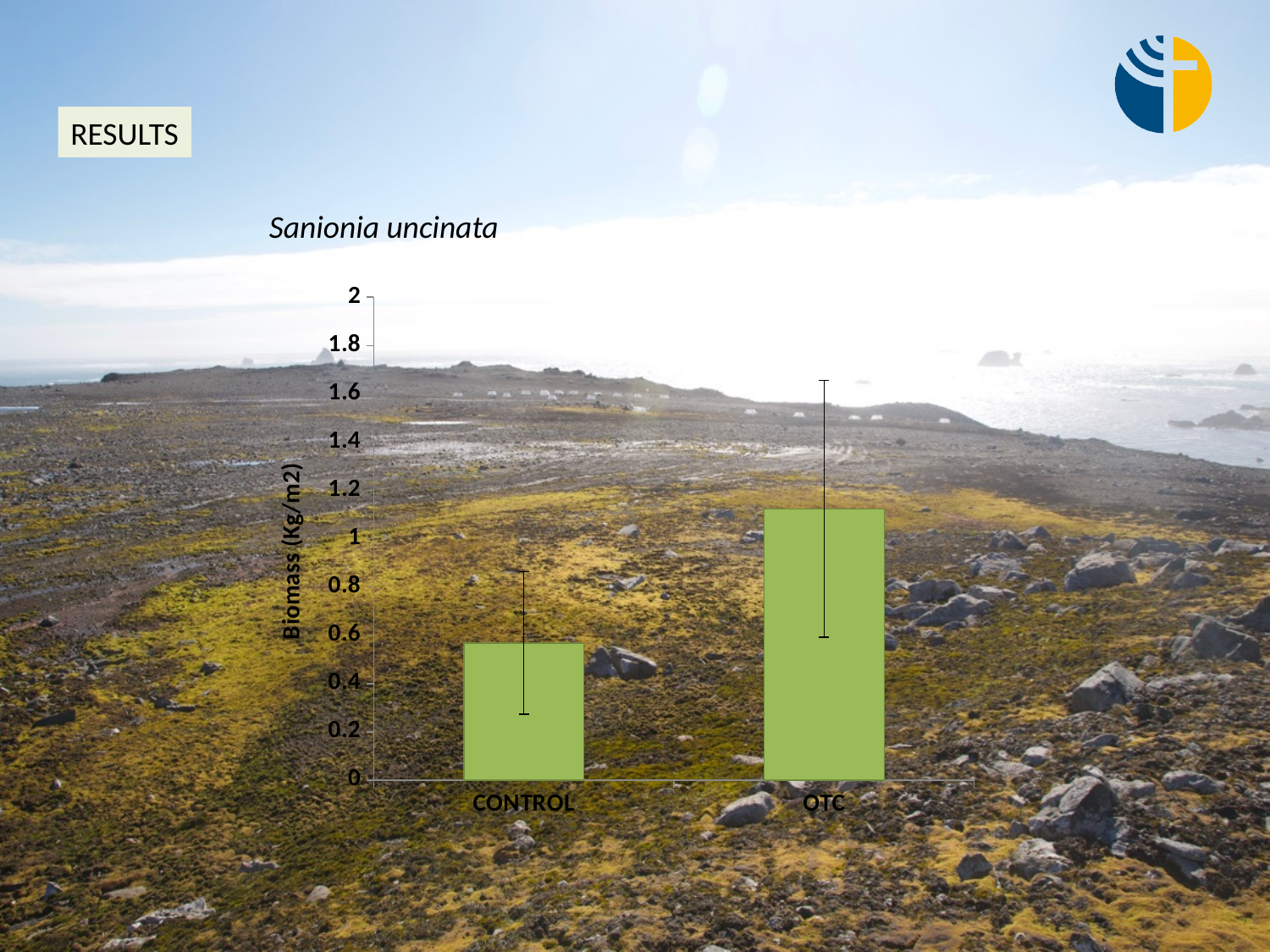
Is the biomass value for OTC greater or less than 1? greater What species name is given as the title above the chart? Sanionia uncinata Which has the larger biomass value, CONTROL or OTC? OTC Which category has the lowest biomass in the chart? CONTROL Is the biomass value for CONTROL greater or less than 0.8? less What kind of chart is shown on the slide? bar chart Which category has the highest biomass in the chart? OTC Is the biomass value for OTC greater or less than 1.4? less How many categories are plotted on the x axis of the chart? 2 What is the label of the y axis of the chart? Biomass (Kg/m2)